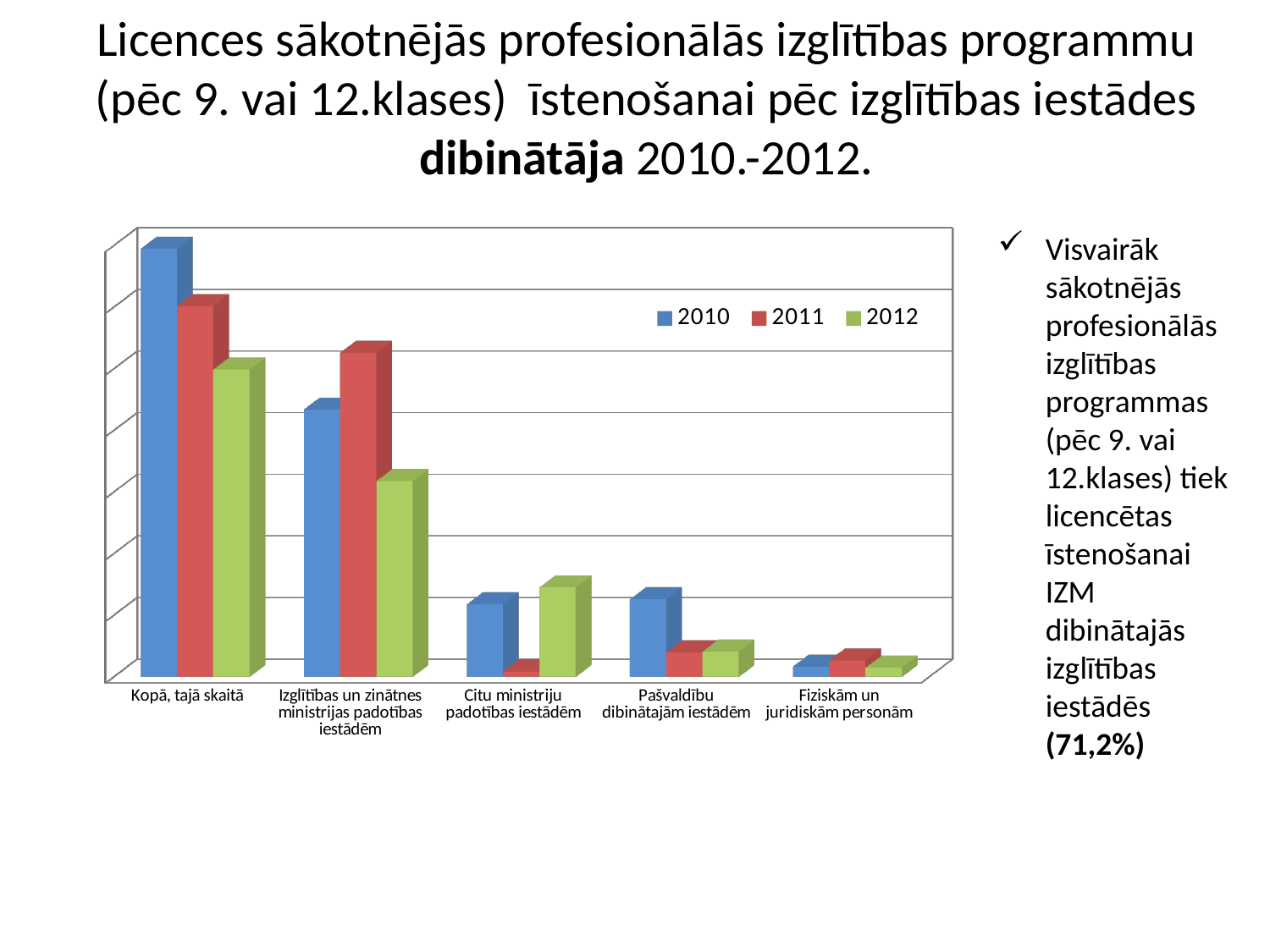
Which series does the legend list first? 2010 Which category has the lowest 2010 value? Fiziskām un juridiskām personām Do the values for 'Kopā, tajā skaitā' rise or fall from 2010 to 2012? fall Which colour represents the 2012 series in the chart? green Which is larger: the 2010 value for 'Izglītības un zinātnes ministrijas padotības iestādēm' or the 2010 value for 'Citu ministriju padotības iestādēm'? Izglītības un zinātnes ministrijas padotības iestādēm How many categories are shown on the x axis of the chart? 5 For the category 'Kopā, tajā skaitā', which year has the highest value? 2010 For the category 'Citu ministriju padotības iestādēm', which year has the lowest value? 2011 Which category has the highest 2010 value? Kopā, tajā skaitā How many series does the legend list? 3 What kind of chart is shown on the slide? bar chart For the category 'Izglītības un zinātnes ministrijas padotības iestādēm', which year has the highest value? 2011